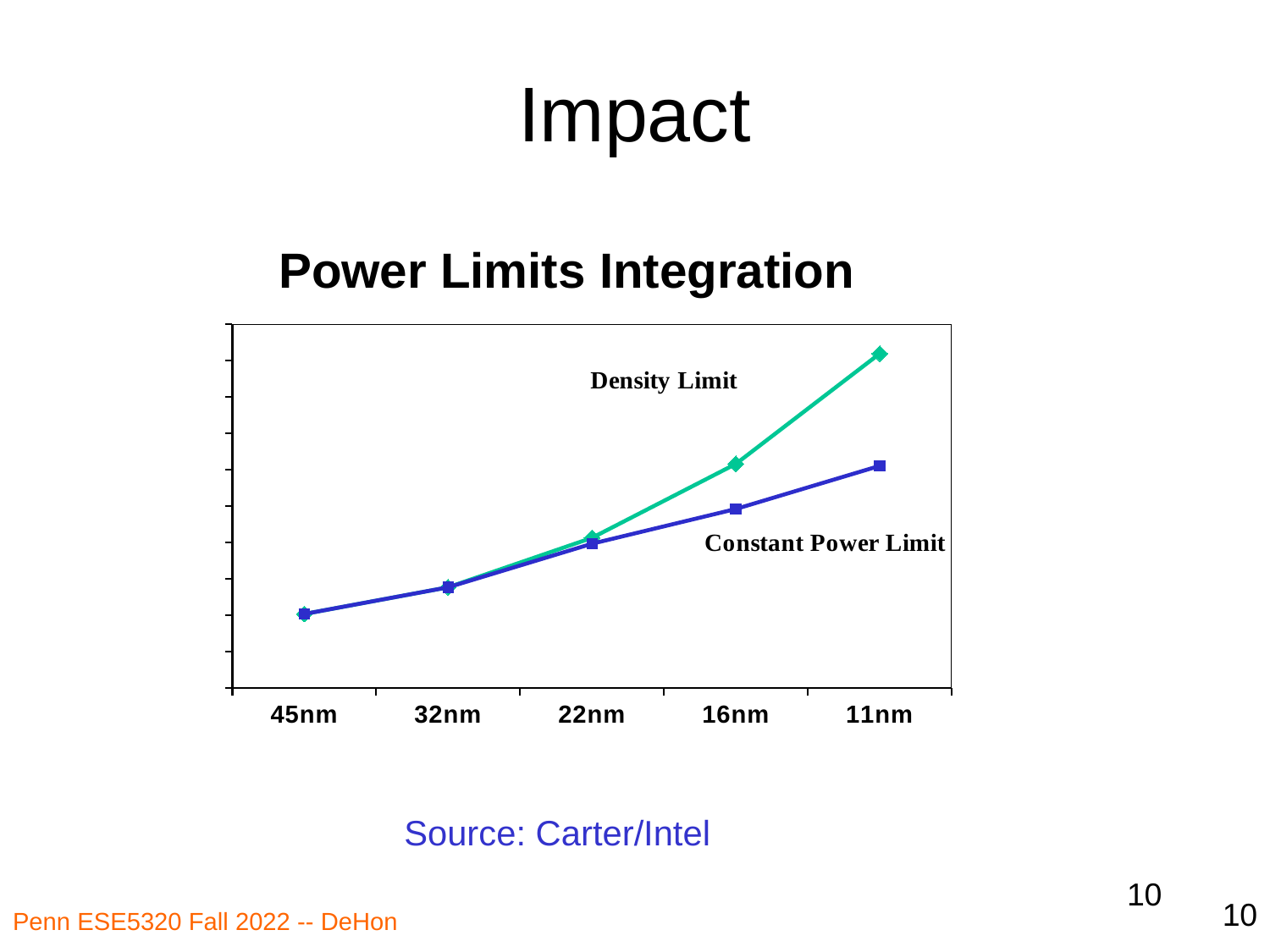
What is the title of the chart? Power Limits Integration At which process node does the Constant Power Limit series have its lowest value? 45nm Do the values of the Density Limit series rise or fall from 45nm to 11nm? rise How many process nodes are shown on the x axis of the chart? 5 At 16nm, which series has the larger value, Density Limit or Constant Power Limit? Density Limit At 11nm, which series has the larger value, Density Limit or Constant Power Limit? Density Limit Which process node is the first label on the x axis? 45nm What kind of chart is shown on the slide? line chart At which process node does the Density Limit series reach its highest value? 11nm Do the values of the Constant Power Limit series rise or fall from 45nm to 11nm? rise How many series are plotted in the chart? 2 What are the names of the two series plotted in the chart? Density Limit and Constant Power Limit